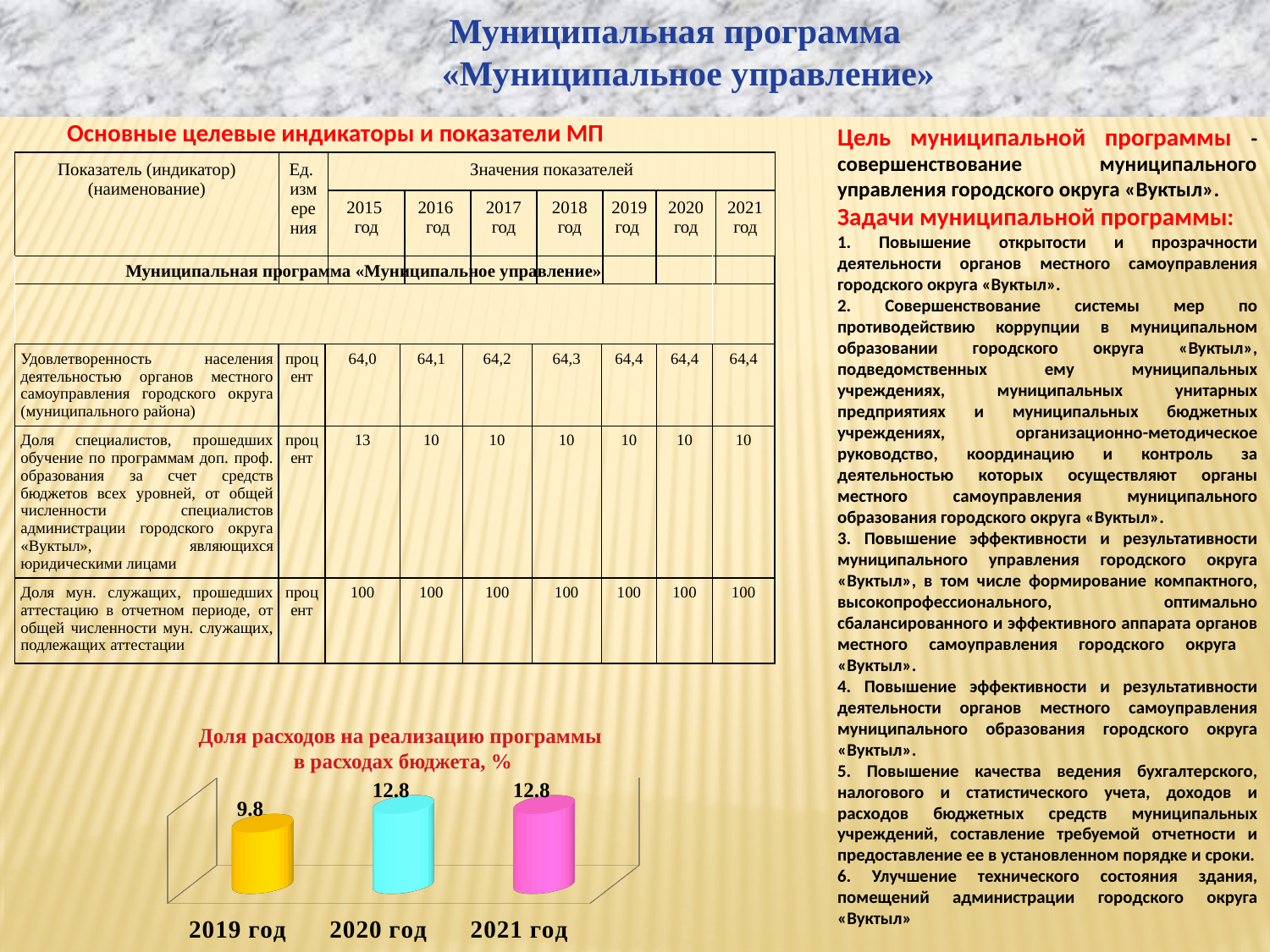
Which year has the lowest value in the chart "Доля расходов на реализацию программы в расходах бюджета, %"? 2019 год What is the value for 2019 год in the chart "Доля расходов на реализацию программы в расходах бюджета, %"? 9.8 What is the value for 2020 год in the chart "Доля расходов на реализацию программы в расходах бюджета, %"? 12.8 What colour is the bar for 2019 год in the chart "Доля расходов на реализацию программы в расходах бюджета, %"? Yellow In the chart "Доля расходов на реализацию программы в расходах бюджета, %", what is the difference between the values for 2020 год and 2019 год? 3.0 In the chart "Доля расходов на реализацию программы в расходах бюджета, %", which is larger: the value for 2019 год or the value for 2020 год? 2020 год How many years (categories) are shown in the chart "Доля расходов на реализацию программы в расходах бюджета, %"? 3 What is the title of the chart at the bottom left of the slide? Доля расходов на реализацию программы в расходах бюджета, % What is the value for 2021 год in the chart "Доля расходов на реализацию программы в расходах бюджета, %"? 12.8 How do the values change from 2019 год to 2021 год in the chart "Доля расходов на реализацию программы в расходах бюджета, %"? They rise from 2019 to 2020, then stay the same in 2021 Do the values for 2020 год and 2021 год differ in the chart "Доля расходов на реализацию программы в расходах бюджета, %"? No, both are 12.8 What kind of chart is "Доля расходов на реализацию программы в расходах бюджета, %"? Bar chart